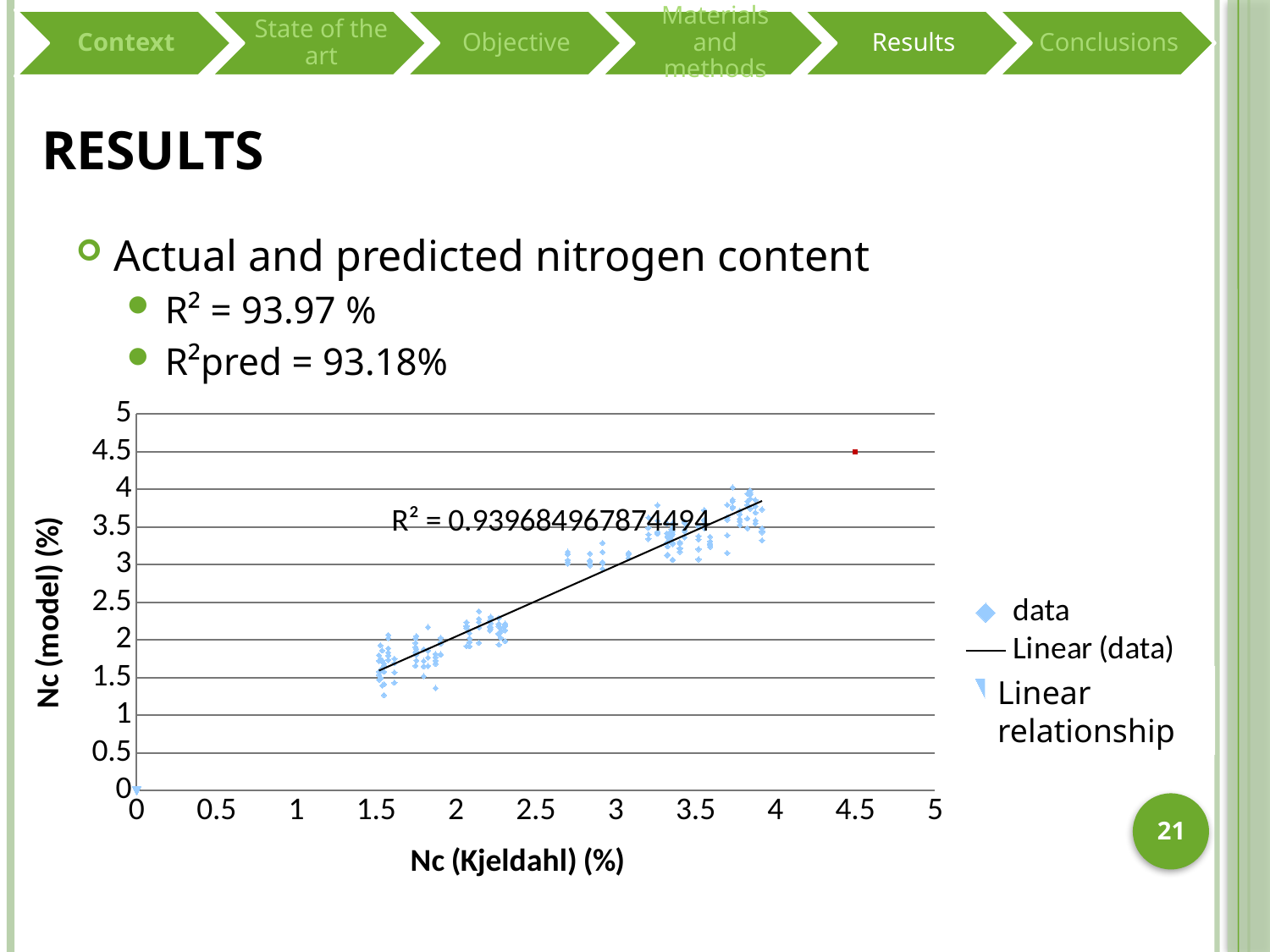
Is the Nc (model) value for the data points near Nc (Kjeldahl) = 3.7 greater or less than 3? greater What is the maximum value shown on the y axis of the chart? 5 Which series in the chart is drawn as a black line? Linear (data) What kind of chart is shown on the slide? scatter chart What is the label of the x axis of the chart? Nc (Kjeldahl) (%) What is the label of the y axis of the chart? Nc (model) (%) What is the R² value printed on the chart? 0.939684967874494 Is the Nc (model) value for the data points near Nc (Kjeldahl) = 3.3 greater or less than 4? less Is the Nc (model) value for the data points near Nc (Kjeldahl) = 2 greater or less than 2.5? less Do the data points in the chart rise or fall as Nc (Kjeldahl) increases? rise How many series does the chart legend list? 3